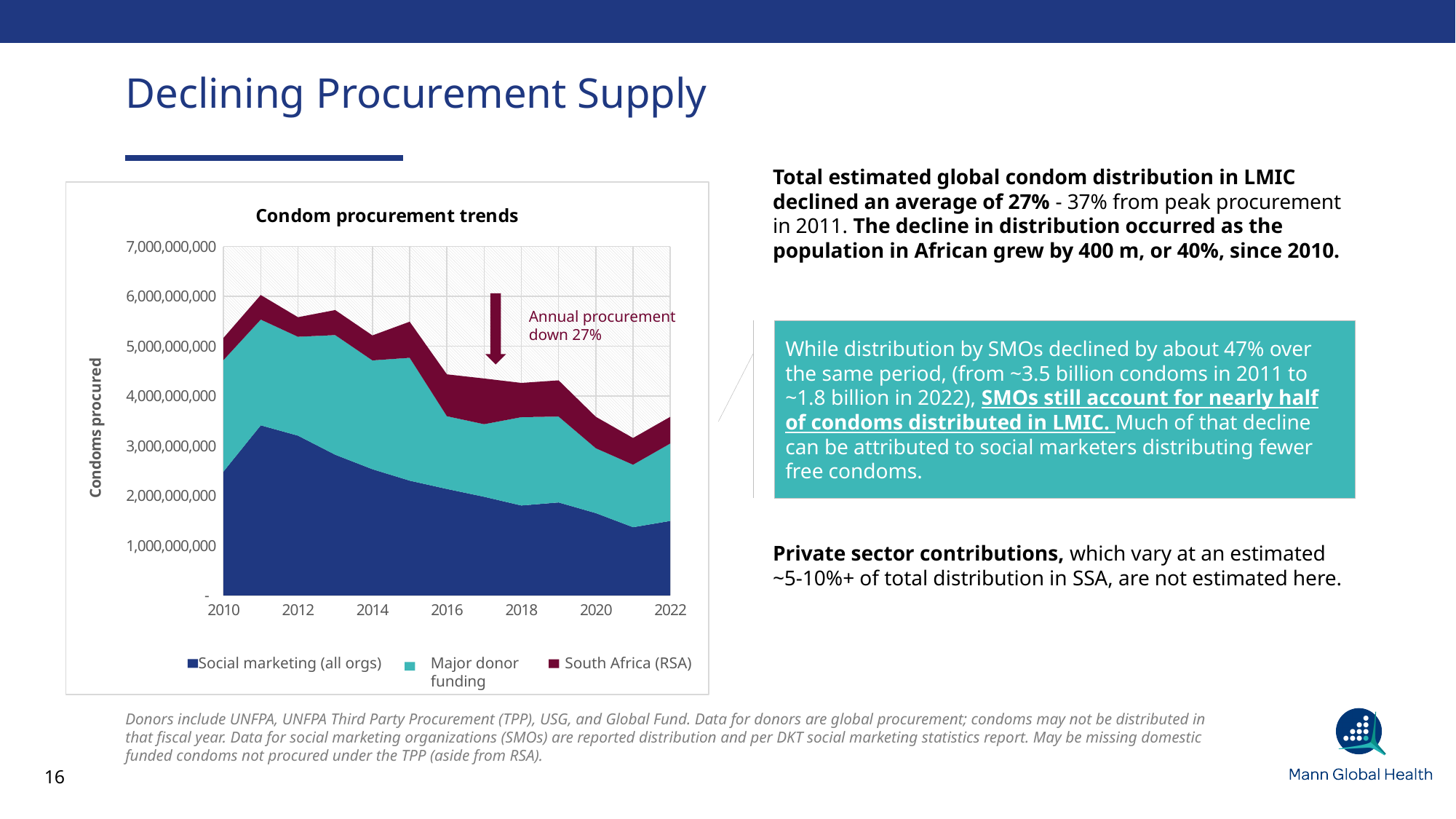
Is the Social marketing (all orgs) value in 2021 greater or less than 2,000,000,000? less What kind of chart is shown on the slide? Stacked area chart In which year is the Social marketing (all orgs) value highest? 2011 In which year does the total stacked procurement reach its highest point? 2011 Which series are listed in the chart's legend? Social marketing (all orgs), Major donor funding, South Africa (RSA) Is the total stacked procurement in 2011 greater or less than 5,000,000,000? greater Does the Social marketing (all orgs) series rise or fall from 2011 to 2022? Fall What is the title of the chart? Condom procurement trends Is the total stacked procurement in 2021 greater or less than 4,000,000,000? less How many series does the chart's legend list? 3 How many years are plotted along the x axis of the chart? 13